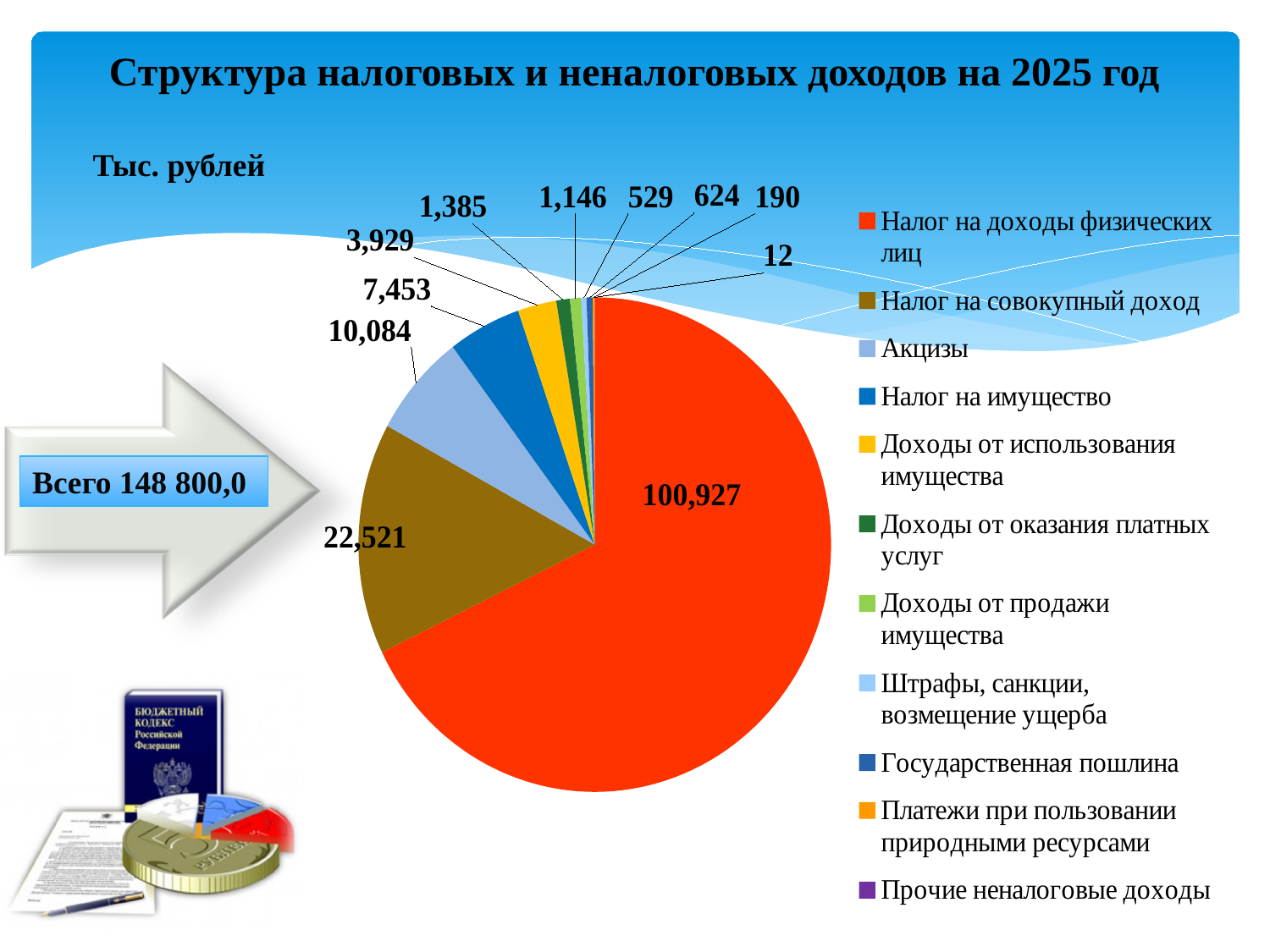
What is the difference between the values for Налог на доходы физических лиц and Налог на совокупный доход? 78,406 How many categories does the legend list? 11 What is the value for Акцизы? 10,084 Which is larger, the value for Акцизы or the value for Налог на имущество? Акцизы Which category has the smallest slice of the pie? Прочие неналоговые доходы What is the value for Налог на имущество? 7,453 What is the value for Доходы от использования имущества? 3,929 What is the value for Налог на совокупный доход? 22,521 What is the value for Налог на доходы физических лиц? 100,927 Which category has the largest slice of the pie? Налог на доходы физических лиц What type of chart is shown on the slide? pie chart What unit of measurement is stated for the chart values? Тыс. рублей